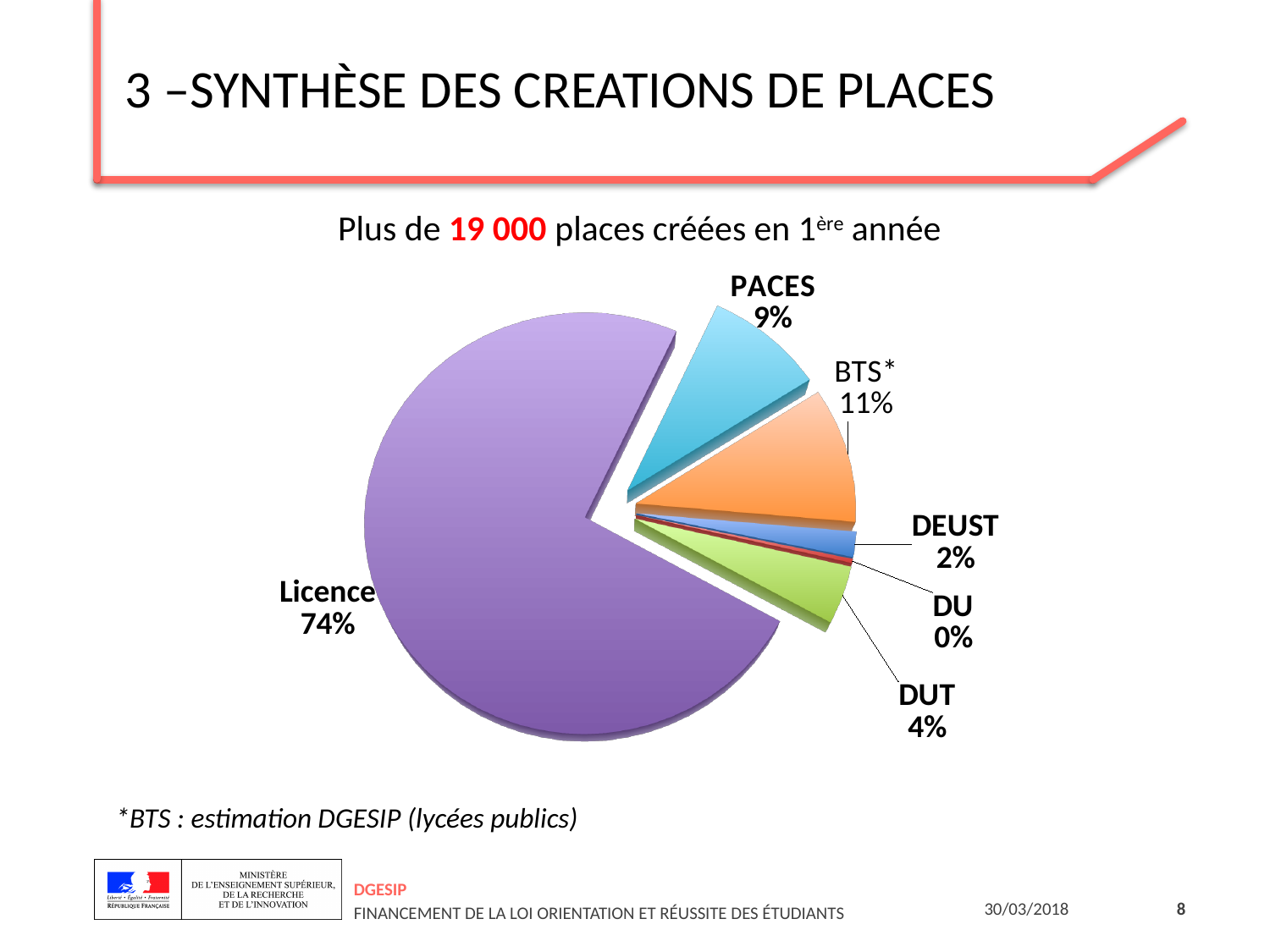
What is the difference in percentage points between BTS* and PACES? 2% What percentage is shown for DUT? 4% Which category has the largest slice of the pie? Licence What share of the pie does Licence represent? 74% How many slices does the pie chart have? 6 Which category has the smallest slice of the pie? DU What kind of chart is shown on the slide? Pie chart What colour is the Licence slice? Purple Which is larger, the share for DUT or the share for DEUST? DUT What percentage is shown for DEUST? 2% What percentage is shown for BTS*? 11% What percentage is shown for PACES? 9%